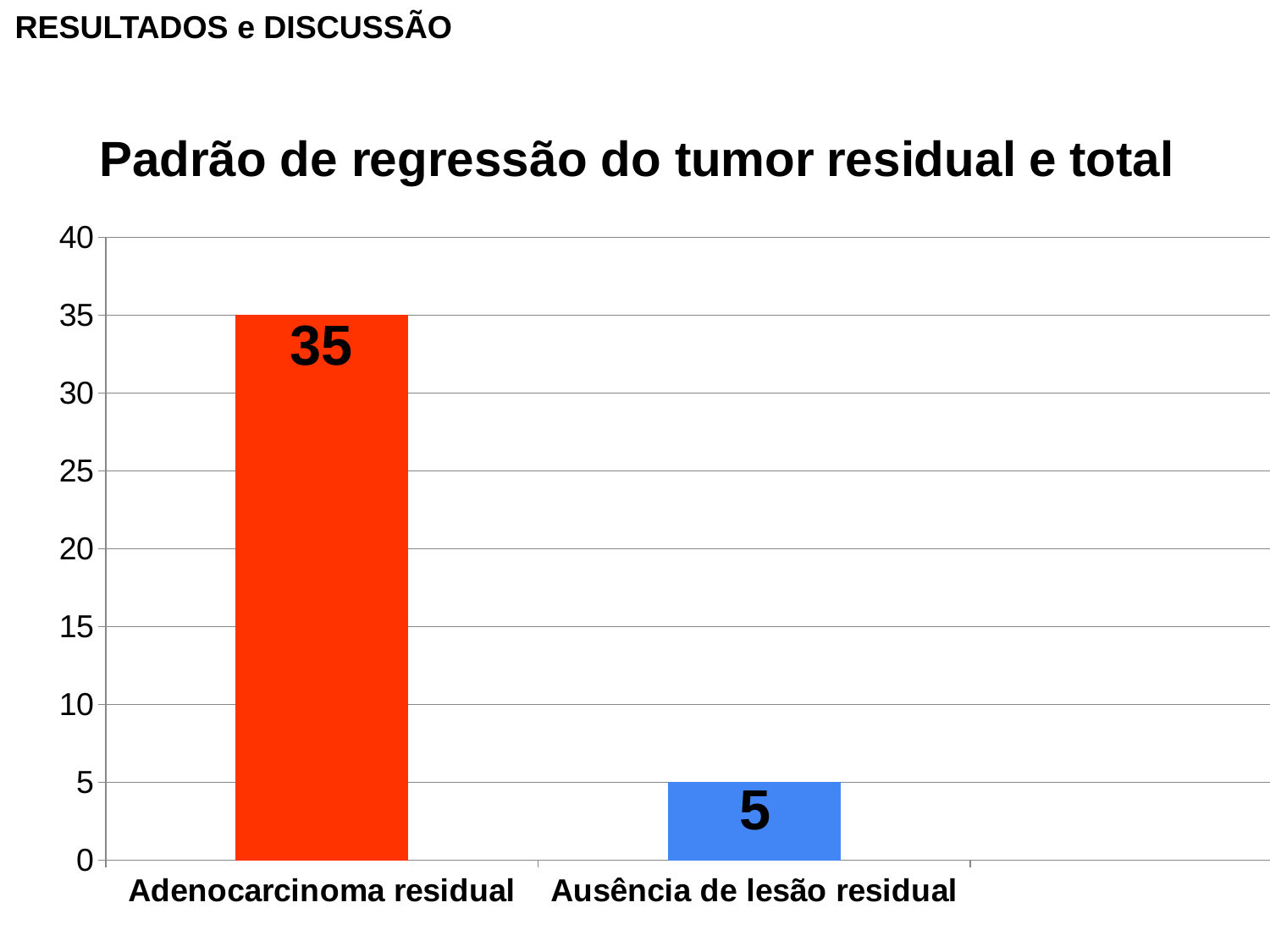
What kind of chart is shown on the slide? bar chart Is the value for Adenocarcinoma residual greater or less than 30? greater How many categories are shown in the chart? 2 What is the difference between the values for Adenocarcinoma residual and Ausência de lesão residual? 30 What is the title of the chart? Padrão de regressão do tumor residual e total Which category has the lowest value? Ausência de lesão residual Which category has the highest value? Adenocarcinoma residual What is the value for Adenocarcinoma residual? 35 What is the value for Ausência de lesão residual? 5 Is the value for Ausência de lesão residual greater or less than 10? less Which is larger, the value for Adenocarcinoma residual or the value for Ausência de lesão residual? Adenocarcinoma residual What colour is the bar for Ausência de lesão residual? blue